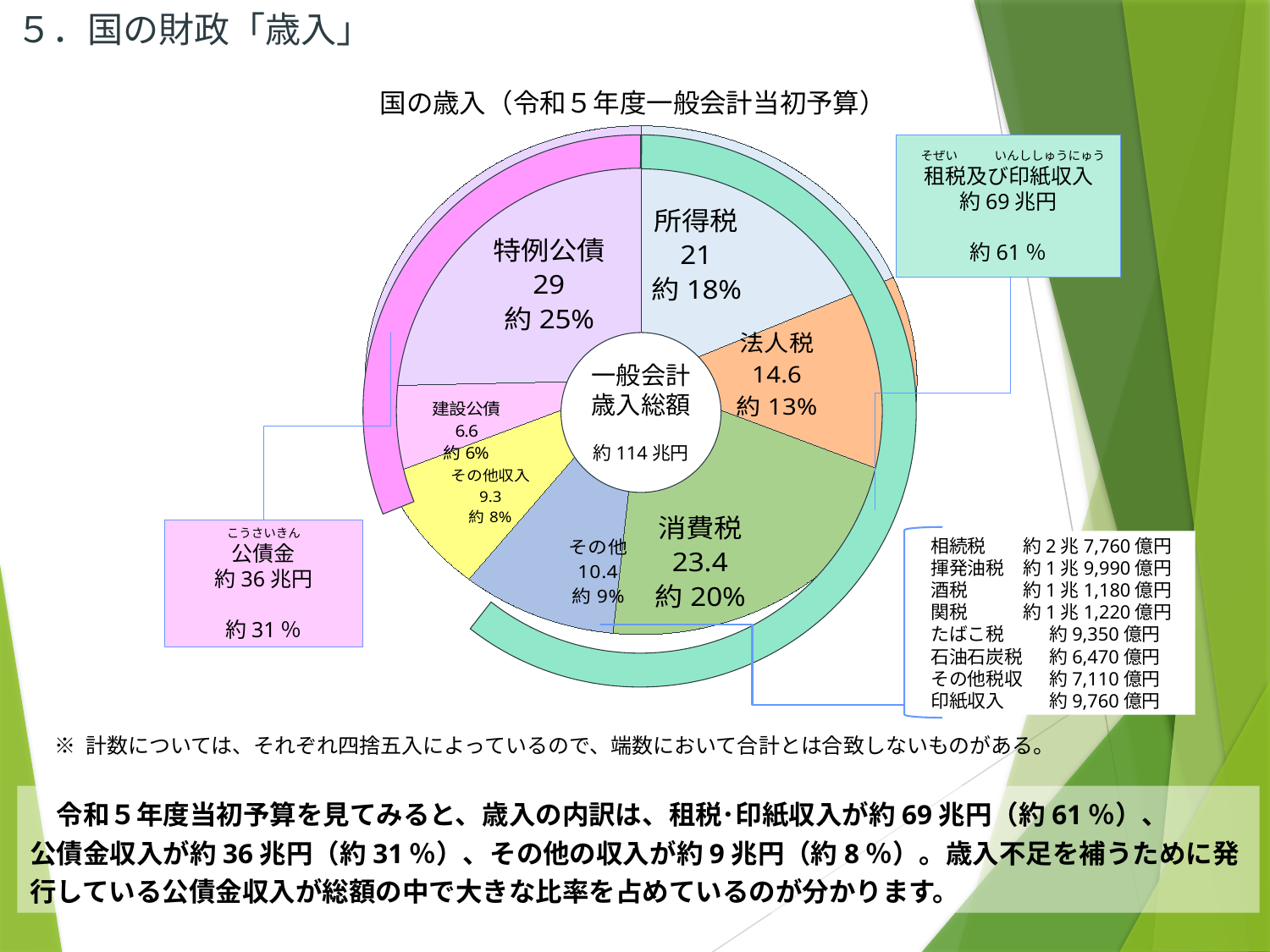
グラフには項目（内側の区分）がいくつありますか？ 7 租税及び印紙収入の合計額はいくらですか？ 約69兆円 グラフの中で最も大きい項目はどれですか？ 特例公債 消費税の割合は何％ですか？ 約20% 法人税とその他では、どちらの値が大きいですか？ 法人税 グラフのタイトルは何ですか？ 国の歳入（令和５年度一般会計当初予算） 法人税の割合は何％ですか？ 約13% グラフの中で最も小さい項目はどれですか？ 建設公債 所得税の値はいくらですか？ 21 グラフの中央に示されている一般会計歳入総額はいくらですか？ 約114兆円 このスライドのグラフはどの種類のグラフですか？ 円グラフ 消費税と所得税の値の差はいくらですか？ 2.4